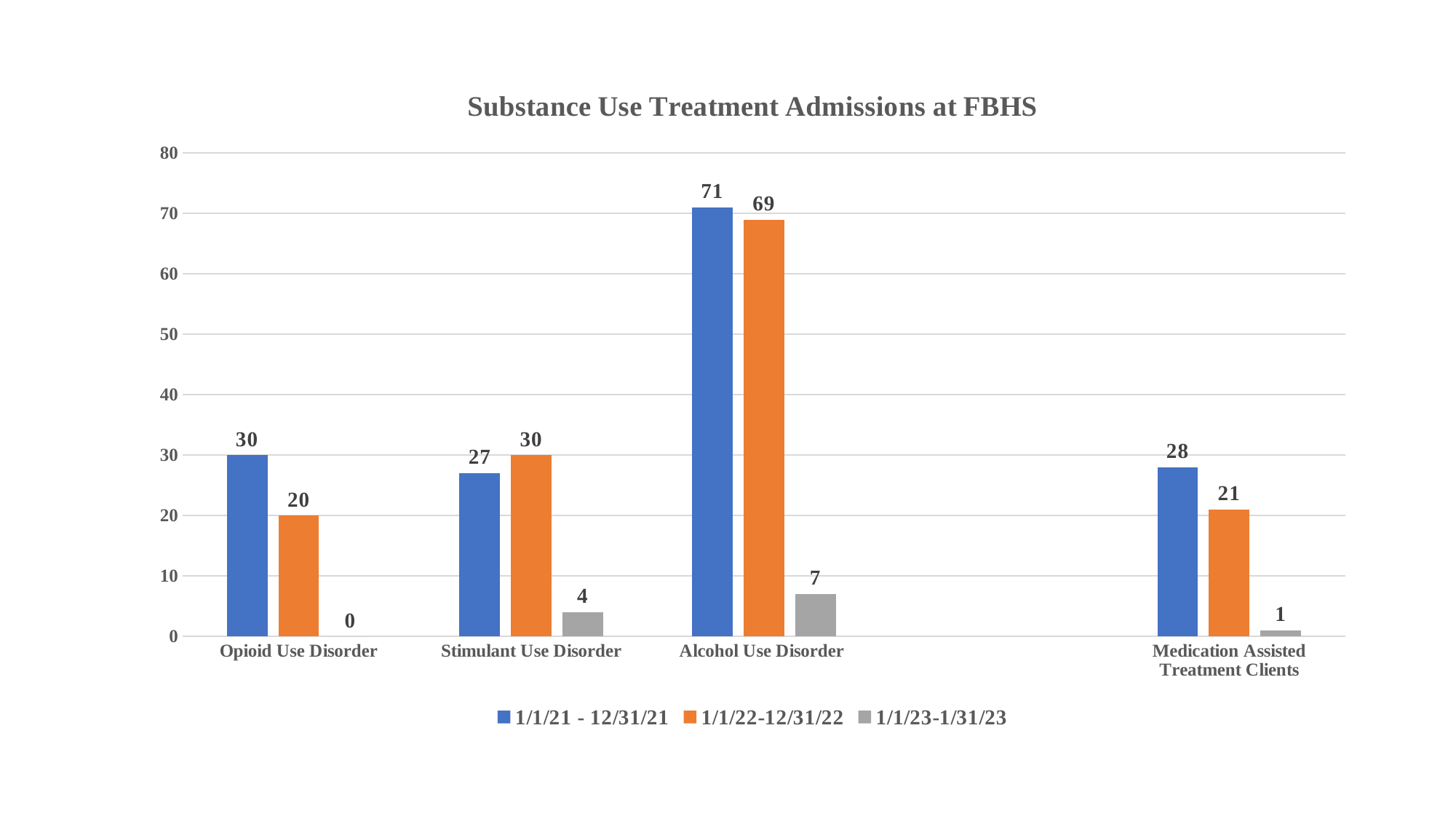
What is the value for Alcohol Use Disorder in the 1/1/21 - 12/31/21 series? 71 Which category has the highest value in the 1/1/22-12/31/22 series? Alcohol Use Disorder Which is larger for Stimulant Use Disorder: the 1/1/21 - 12/31/21 value or the 1/1/22-12/31/22 value? 1/1/22-12/31/22 How many categories are shown on the x axis? 4 How many series does the legend list? 3 What is the value for Medication Assisted Treatment Clients in the 1/1/21 - 12/31/21 series? 28 What is the title of the chart? Substance Use Treatment Admissions at FBHS What is the value for Stimulant Use Disorder in the 1/1/23-1/31/23 series? 4 What is the value for Opioid Use Disorder in the 1/1/22-12/31/22 series? 20 What kind of chart is shown on the slide? Bar chart What is the difference between the 1/1/21 - 12/31/21 and 1/1/22-12/31/22 values for Opioid Use Disorder? 10 Which category has the lowest value in the 1/1/23-1/31/23 series? Opioid Use Disorder